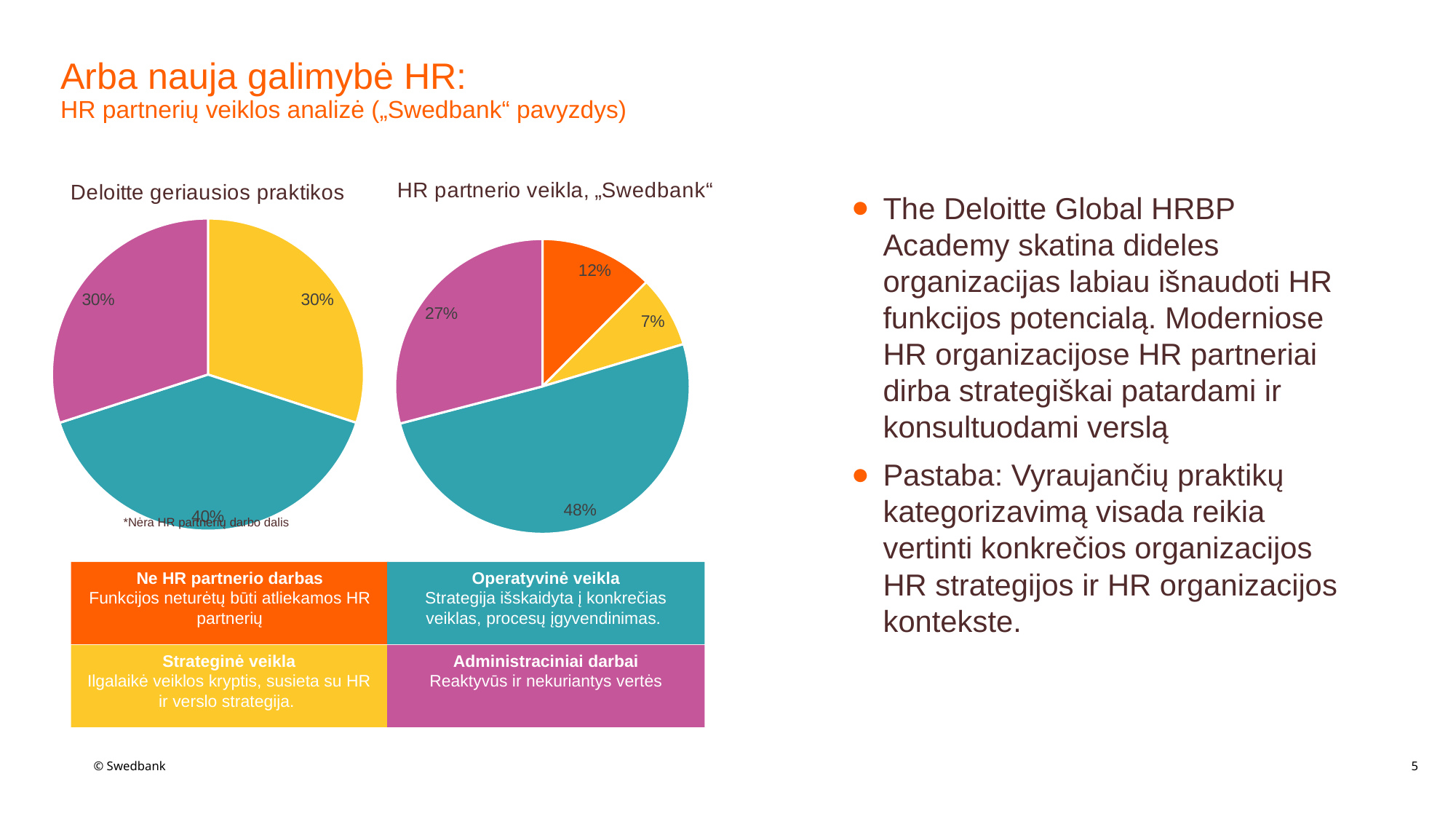
How many slices does the "HR partnerio veikla, „Swedbank“" pie chart have? 4 Which is larger: the Strateginė veikla share in the "Deloitte geriausios praktikos" chart or in the "HR partnerio veikla, „Swedbank“" chart? Deloitte geriausios praktikos In the "HR partnerio veikla, „Swedbank“" pie chart, what share is labelled for Strateginė veikla (the yellow slice)? 7% In the "Deloitte geriausios praktikos" pie chart, what share is labelled for Operatyvinė veikla (the teal slice)? 40% In the "HR partnerio veikla, „Swedbank“" pie chart, what share is labelled for Operatyvinė veikla (the teal slice)? 48% In the "HR partnerio veikla, „Swedbank“" pie chart, which category has the smallest slice? Strateginė veikla In the "Deloitte geriausios praktikos" pie chart, what share is labelled for Strateginė veikla (the yellow slice)? 30% In the "HR partnerio veikla, „Swedbank“" pie chart, what share is labelled for Ne HR partnerio darbas (the orange slice)? 12% In the "HR partnerio veikla, „Swedbank“" pie chart, what share is labelled for Administraciniai darbai (the magenta slice)? 27% In the "HR partnerio veikla, „Swedbank“" pie chart, which category has the largest slice? Operatyvinė veikla What is the difference between the Operatyvinė veikla share in the "HR partnerio veikla, „Swedbank“" chart and in the "Deloitte geriausios praktikos" chart? 8 percentage points What type of chart is used for "Deloitte geriausios praktikos"? Pie chart